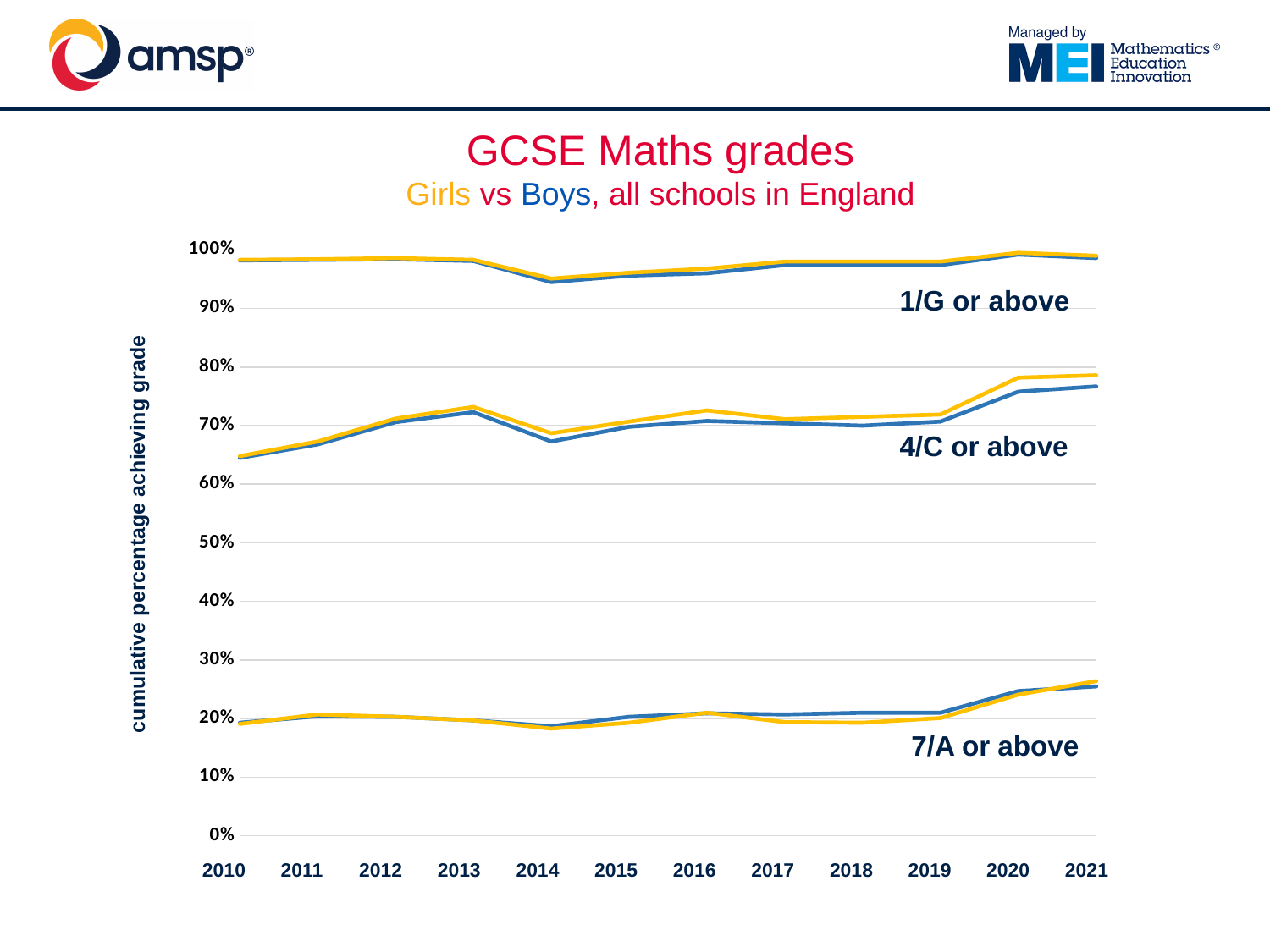
Is the value for boys achieving 4/C or above in 2014 greater or less than 70%? less How many years are shown along the x axis of the chart? 12 For 4/C or above in 2020, which is higher: girls or boys? girls What kind of chart is shown on the slide? line chart Is the value for 7/A or above in 2021 greater or less than 20%? greater What is the label on the y axis of the chart? cumulative percentage achieving grade For 4/C or above, is the value in 2021 higher or lower than in 2010? higher Do the 4/C or above lines rise or fall between 2019 and 2021? rise How many grade bands (labelled line groups) are plotted on the chart? 3 What is the title of the chart? GCSE Maths grades Is the value for girls achieving 4/C or above in 2021 greater or less than 70%? greater